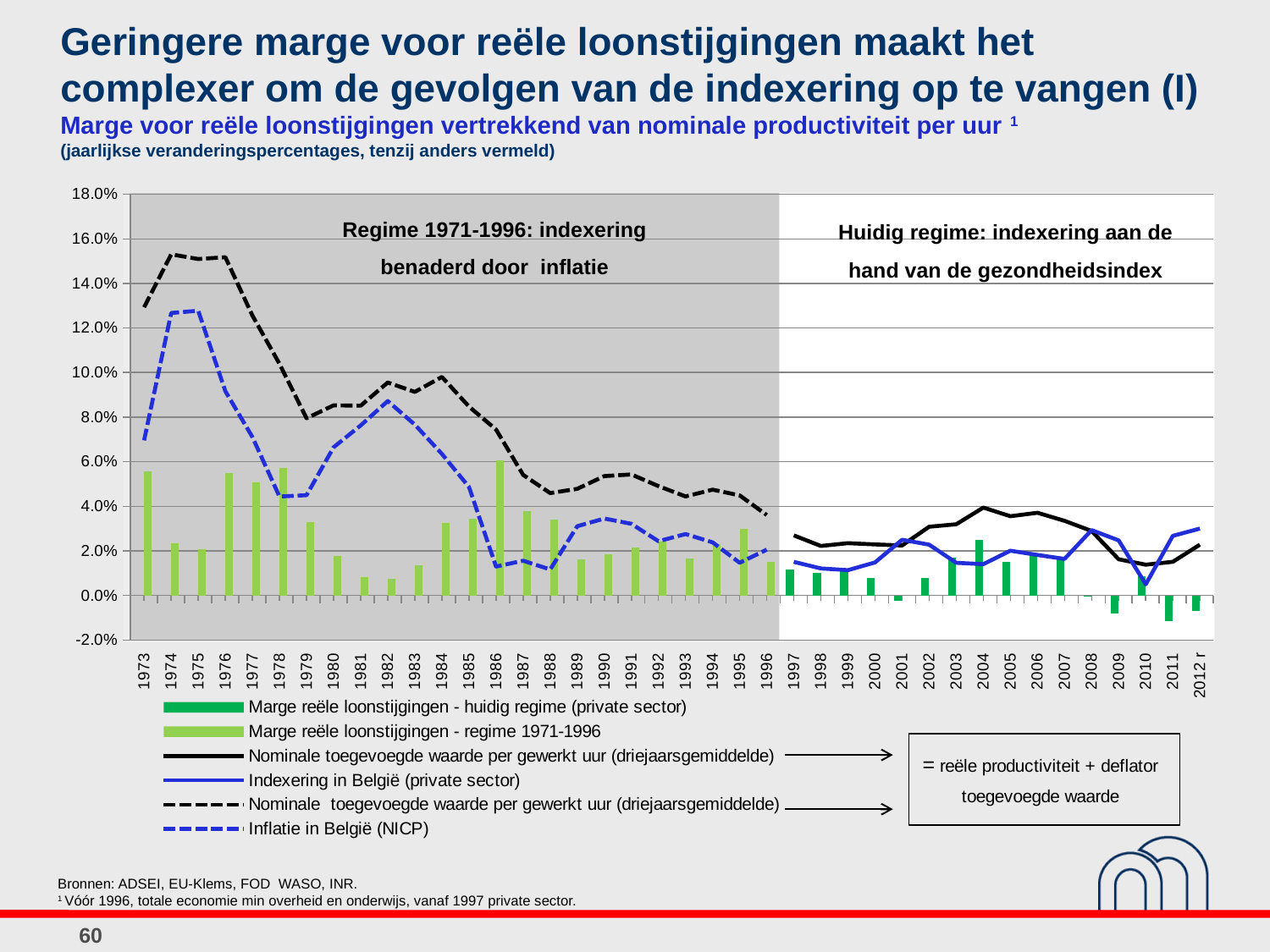
Does the dashed black line (Nominale toegevoegde waarde per gewerkt uur) rise or fall between 1974 and 1979? Fall Is the value of the dashed blue line (Inflatie in België) in 1974 greater or less than 12.0%? greater Which year has the lowest green bar (Marge reële loonstijgingen) in the chart? 2011 In 2011, which is larger: the solid blue line (Indexering in België) or the solid black line (Nominale toegevoegde waarde per gewerkt uur)? The solid blue line Is the green bar (Marge reële loonstijgingen) for 1973 greater or less than 4.0%? greater How many years are shown along the x axis (from 1973 to 2012 r)? 40 Is the green bar (Marge reële loonstijgingen) for 2011 greater or less than 0.0%? less How many series does the legend list? 6 In 1974, which is larger: the dashed black line (Nominale toegevoegde waarde per gewerkt uur) or the dashed blue line (Inflatie in België)? The dashed black line What kind of chart is shown on the slide? A combined bar and line chart